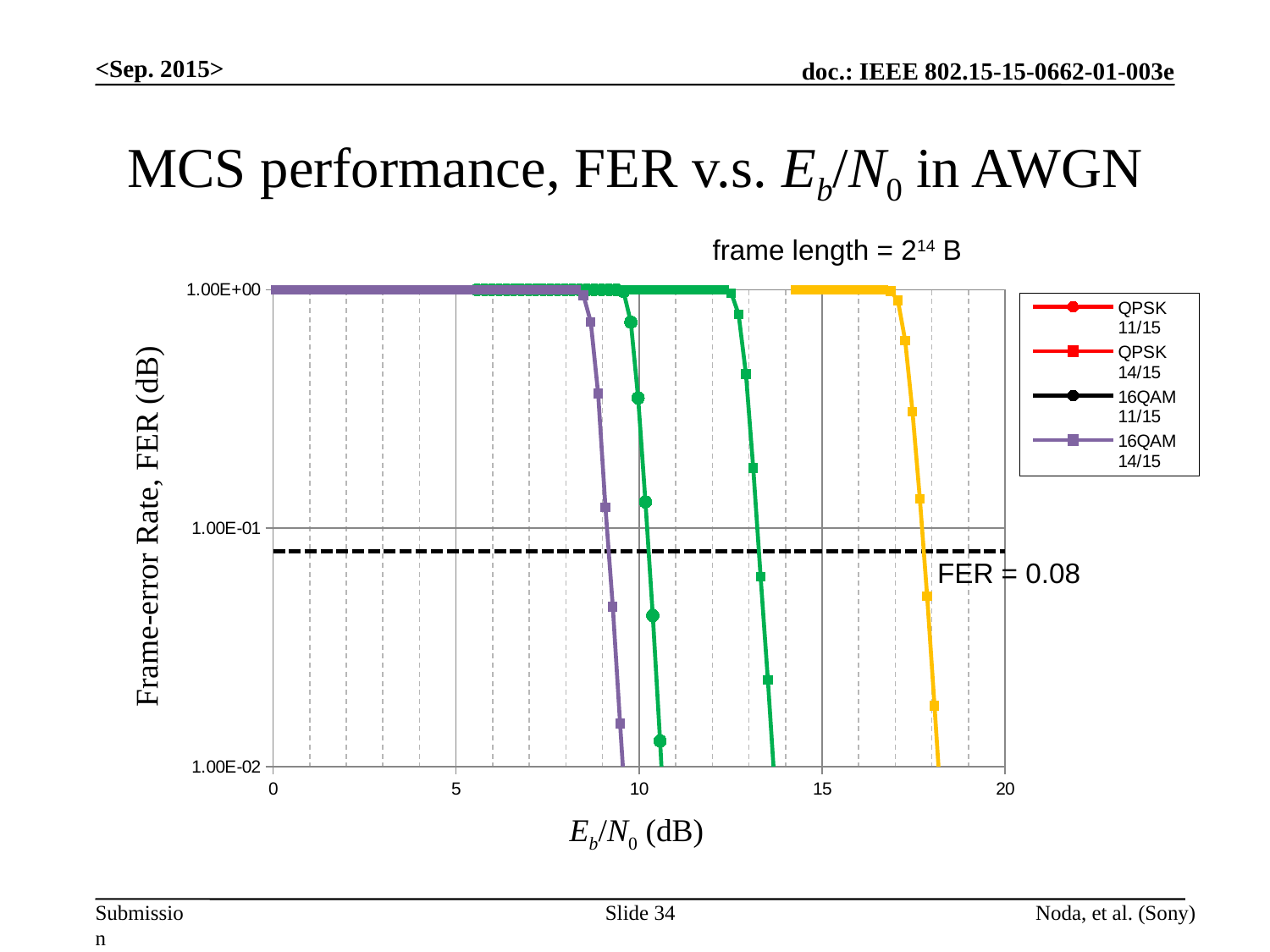
What frame length is stated in the annotation above the chart? 2^14 B Do the FER curves rise or fall as Eb/N0 increases along the x axis? fall What is the lowest tick value shown on the y axis of the chart? 1.00E-02 What is the highest value shown on the x axis of the chart? 20 What is the title of the chart on the slide? MCS performance, FER v.s. Eb/N0 in AWGN What is the label of the x axis of the chart? Eb/N0 (dB) What kind of chart is shown on the slide? line chart What FER value does the horizontal dashed line on the chart mark? FER = 0.08 How many series does the chart legend list? 4 Is the dashed FER = 0.08 line above or below the 1.00E-01 gridline on the y axis? below